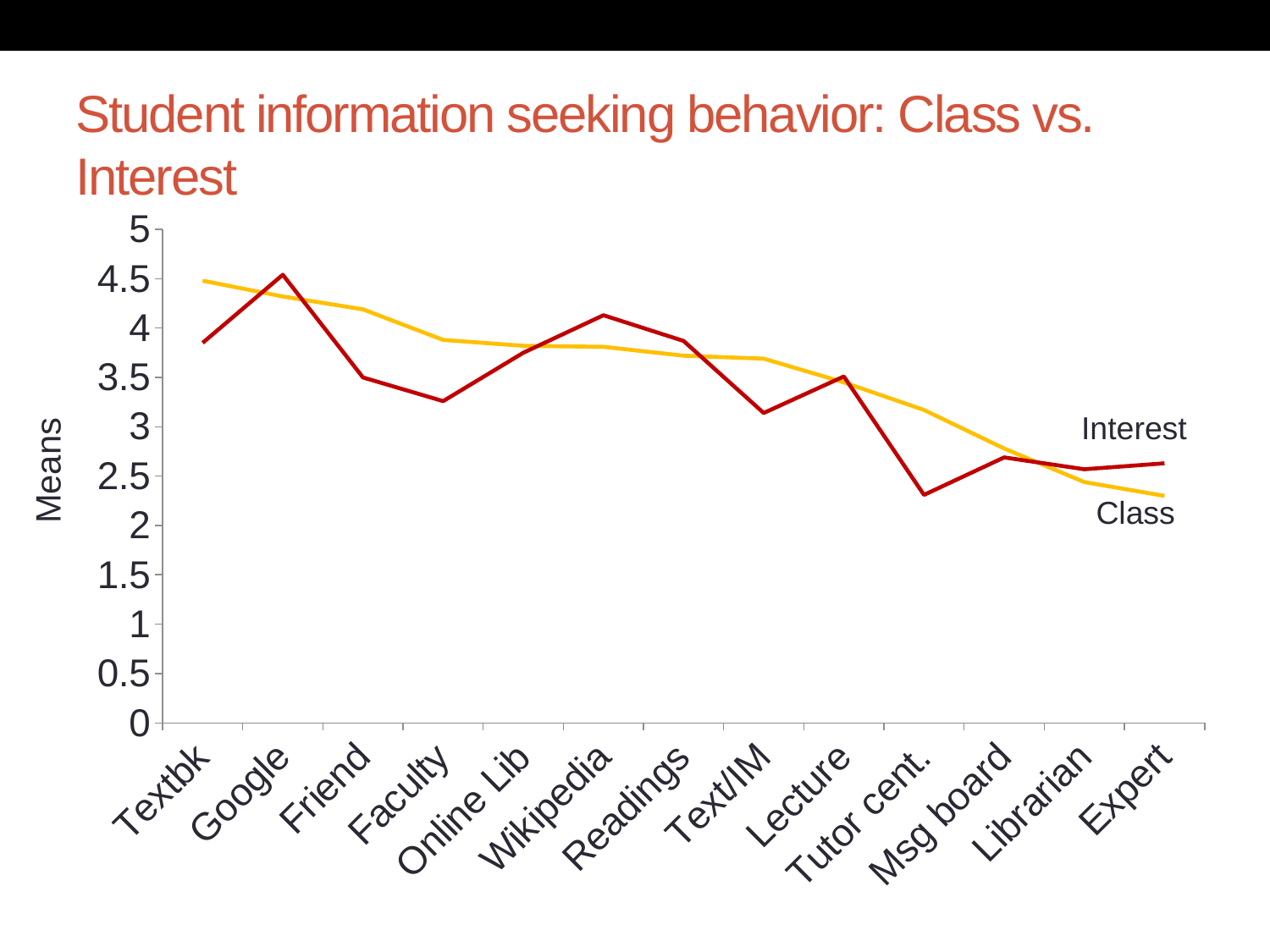
What is the label on the y axis? Means Which category has the highest value for the Interest series? Google Which category has the highest value for the Class series? Textbk Is the Interest value for Tutor cent. greater or less than 2.5? less How many categories are shown along the x axis? 13 How many data series are plotted on the chart? 2 Is the Class value for Textbk greater or less than 4? greater At Wikipedia, which series has the larger value, Class or Interest? Interest Which category has the lowest value for the Interest series? Tutor cent. Which category has the lowest value for the Class series? Expert What kind of chart is shown on the slide? Line chart Does the Class series generally rise or fall from Textbk to Expert? Fall